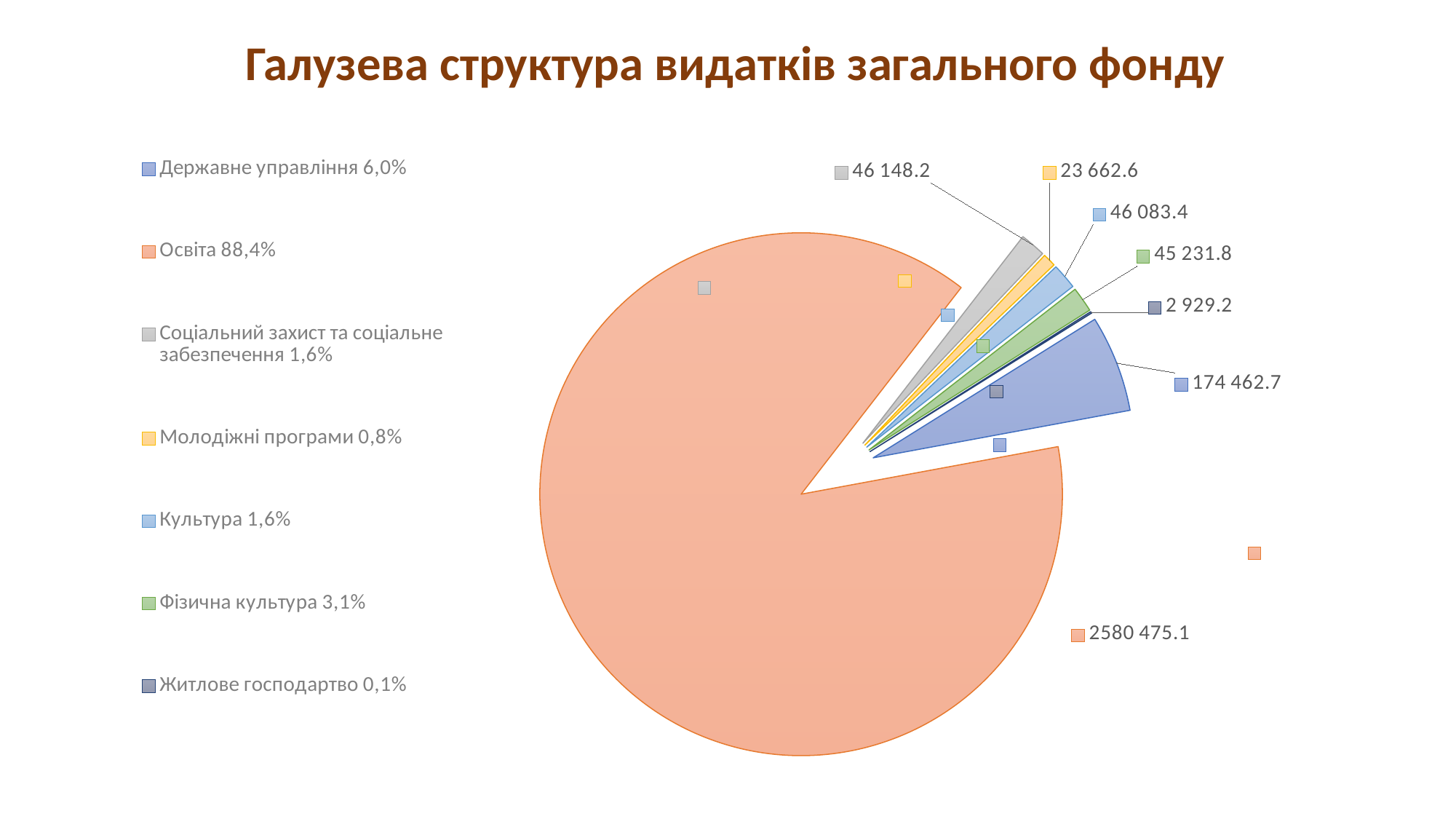
What is the value shown for Молодіжні програми? 23 662.6 Which category has the largest slice? Освіта What share of the pie does Освіта represent according to the legend? 88,4% Which category has the smallest slice? Житлове господартво Which is larger, the value for Державне управління or the value for Фізична культура? Державне управління What kind of chart is shown on the slide? pie chart What is the value shown for Державне управління? 174 462.7 What is the value shown for Освіта? 2580 475.1 What is the title of the chart? Галузева структура видатків загального фонду What is the value shown for Житлове господартво? 2 929.2 What share of the pie does Фізична культура represent according to the legend? 3,1% How many categories does the legend list? 7